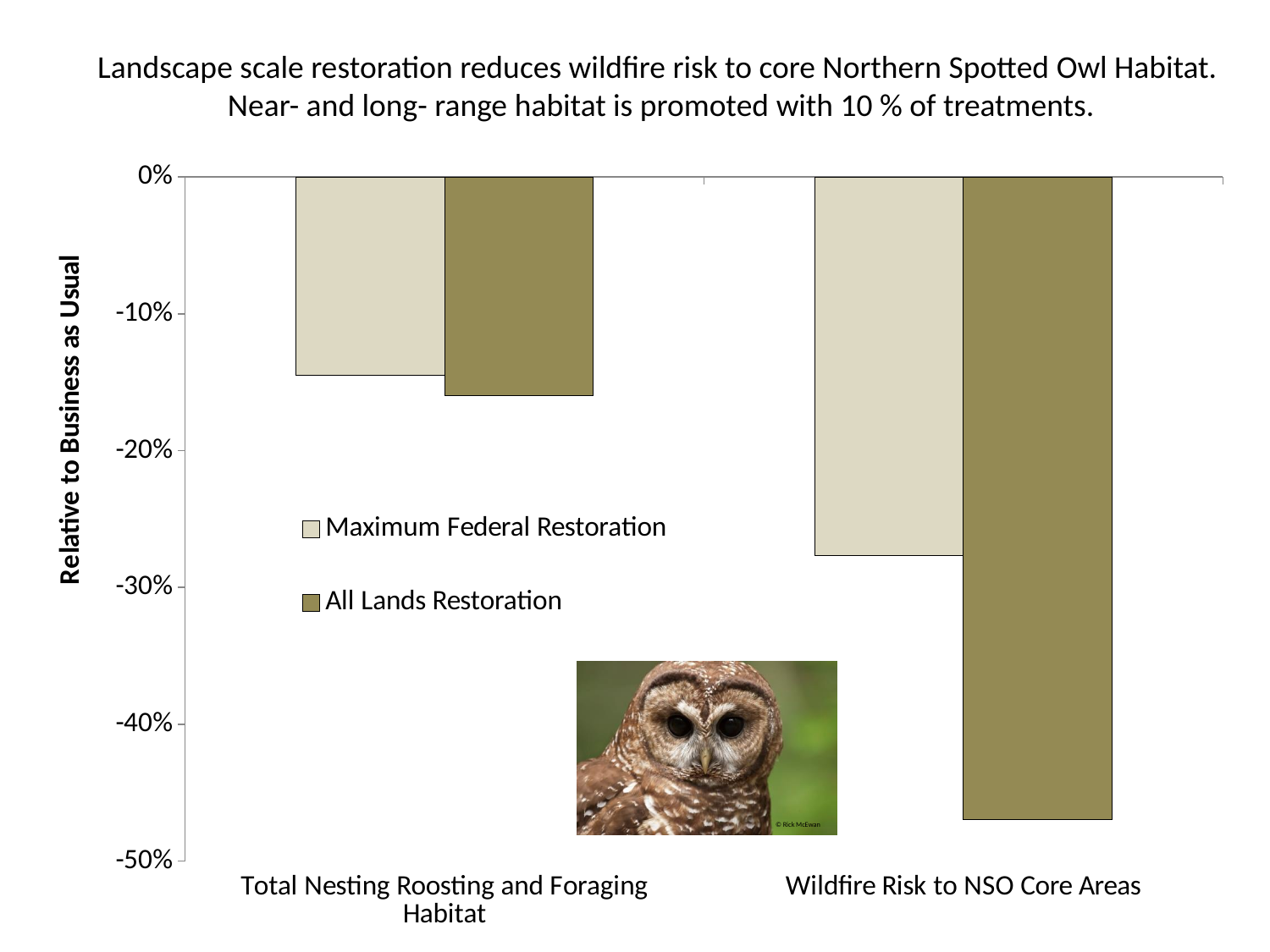
How many series does the chart's legend list? 2 For All Lands Restoration, which category shows the larger reduction: Total Nesting Roosting and Foraging Habitat or Wildfire Risk to NSO Core Areas? Wildfire Risk to NSO Core Areas Which bar on the chart has the lowest (most negative) value? All Lands Restoration for Wildfire Risk to NSO Core Areas For Wildfire Risk to NSO Core Areas, which series shows the larger reduction: Maximum Federal Restoration or All Lands Restoration? All Lands Restoration Is the All Lands Restoration value for Wildfire Risk to NSO Core Areas greater or less than -40%? less What is the title of the chart's vertical axis? Relative to Business as Usual Is the Maximum Federal Restoration value for Total Nesting Roosting and Foraging Habitat greater or less than -10%? less What kind of chart is shown on the slide? bar chart Which series in the legend is drawn in the darker olive colour? All Lands Restoration Which bar on the chart has the highest value (closest to 0%)? Maximum Federal Restoration for Total Nesting Roosting and Foraging Habitat Is the Maximum Federal Restoration value for Wildfire Risk to NSO Core Areas greater or less than -20%? less How many categories are shown on the x axis of the chart? 2